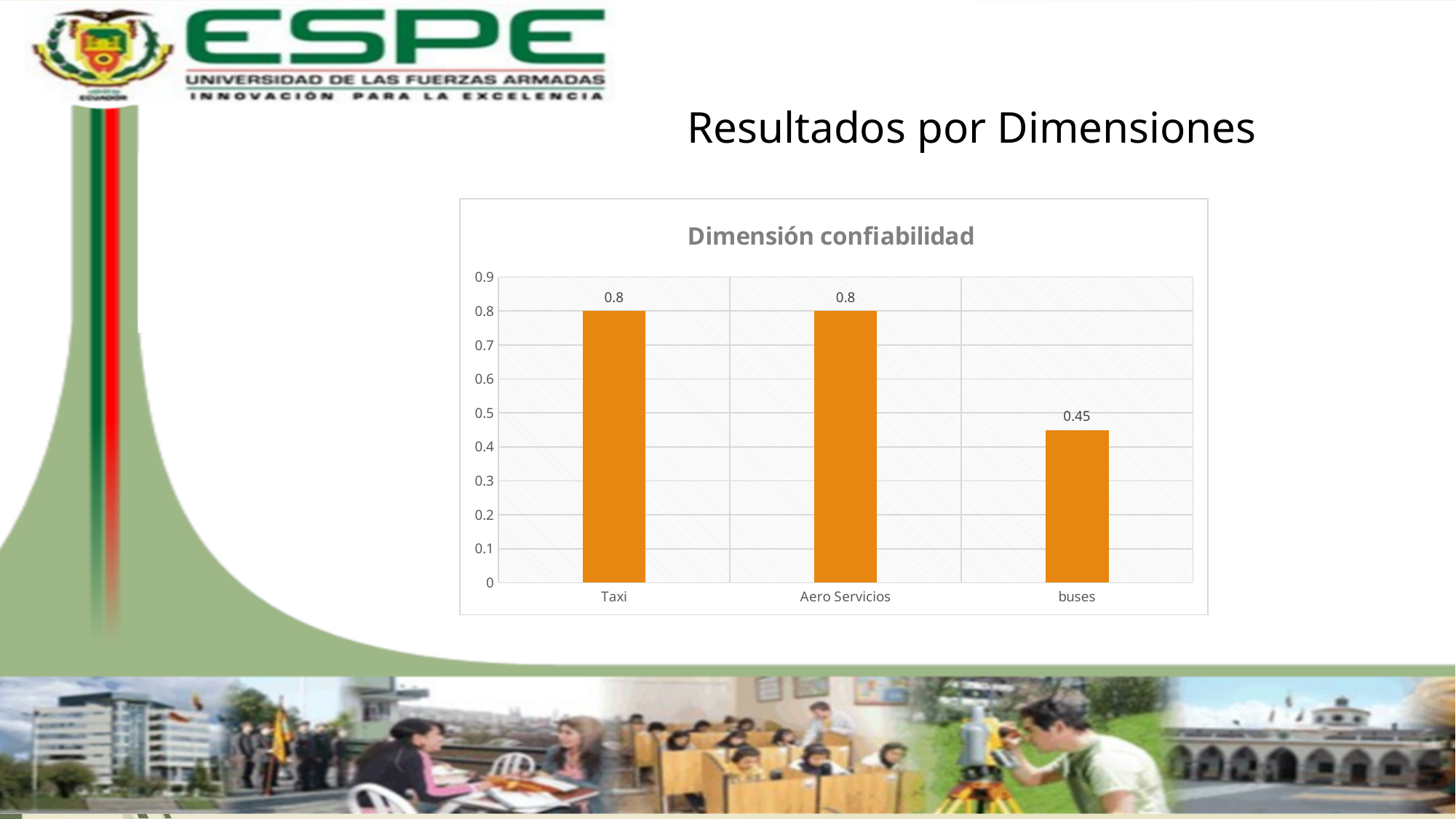
Is the value for Taxi greater or less than 0.7? greater What is the value for Aero Servicios? 0.8 What is the value for Taxi in the Dimensión confiabilidad chart? 0.8 What is the value for buses? 0.45 Is the value for buses greater or less than 0.5? less What is the highest value shown on the y axis? 0.9 Which is larger, the value for Aero Servicios or the value for buses? Aero Servicios What is the difference between the values for Taxi and buses? 0.35 How many categories are shown on the x axis? 3 What is the title of the chart? Dimensión confiabilidad What kind of chart is shown on the slide? bar chart Which category has the lowest value? buses